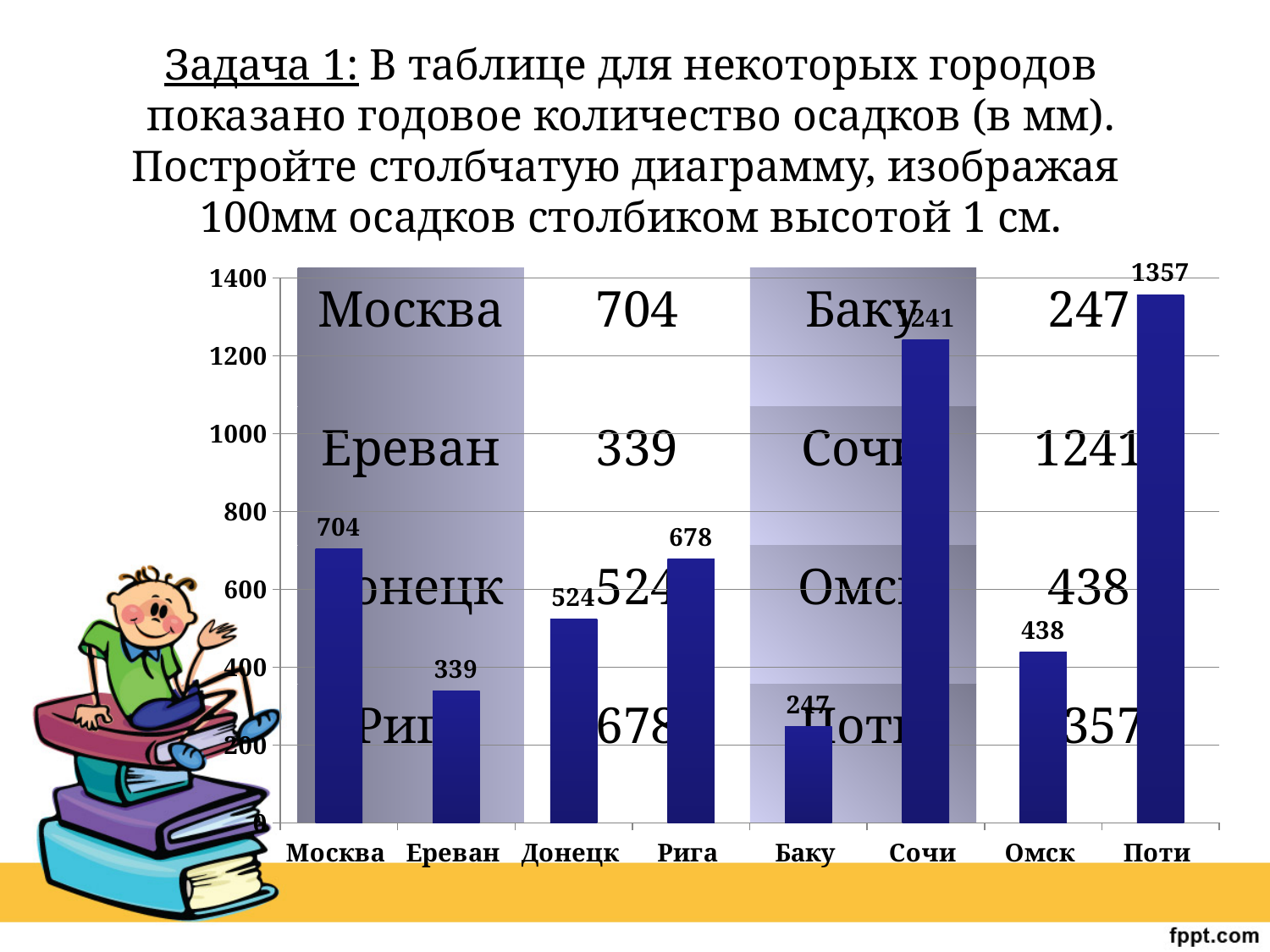
How many cities are shown on the x axis? 8 What is the difference between the values for Москва and Ереван? 365 Which is larger, the value for Донецк or the value for Омск? Донецк What is the difference between the values for Поти and Сочи? 116 What is the value for Москва? 704 What kind of chart is shown on the slide? bar chart What is the value for Баку? 247 Is the value for Рига greater or less than 600? greater What is the value for Сочи? 1241 What is the value for Омск? 438 Which city has the lowest bar? Баку Which city has the highest bar? Поти